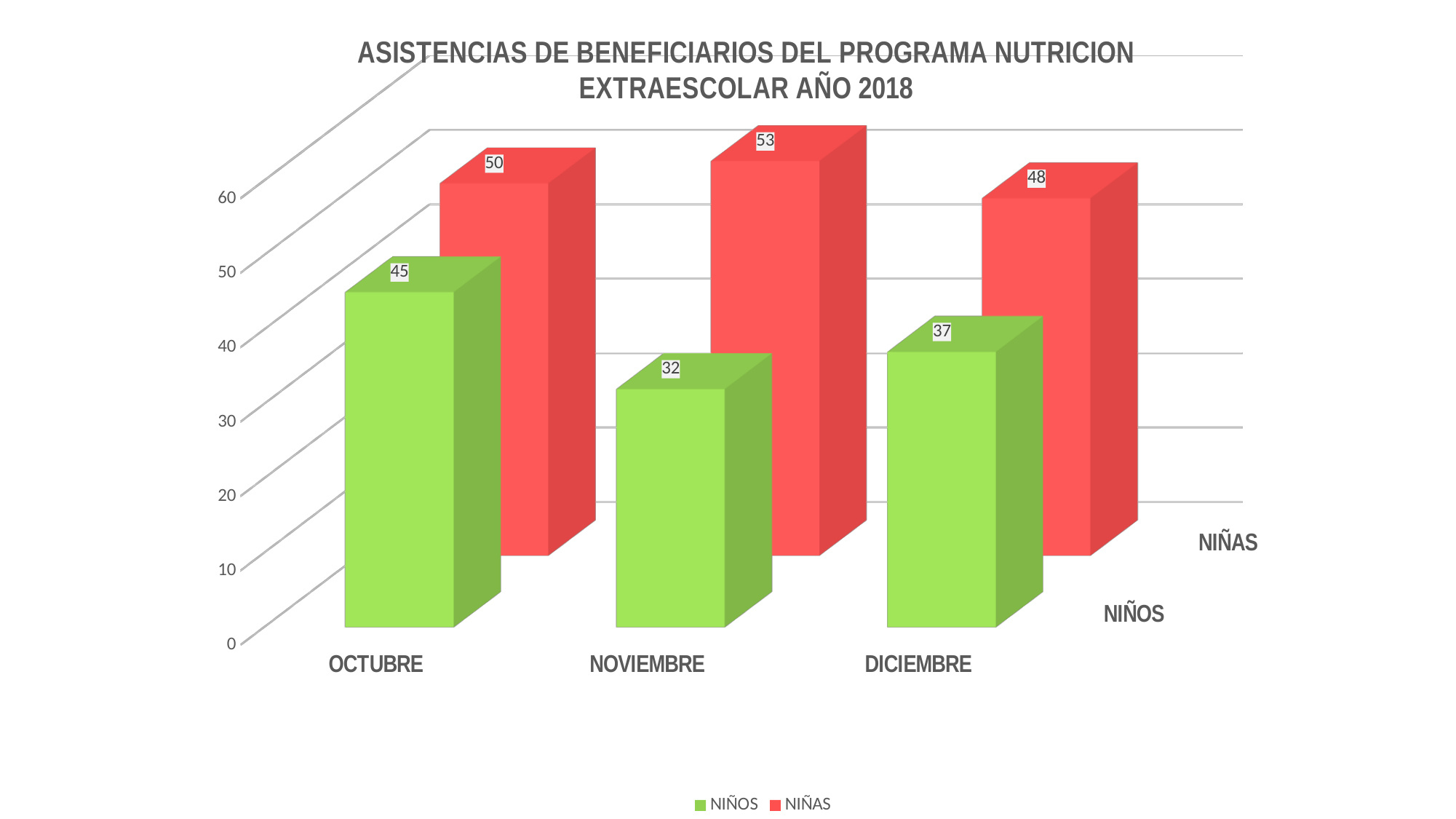
In which month is the NIÑAS value highest? NOVIEMBRE Which is larger in OCTUBRE, the NIÑOS value or the NIÑAS value? NIÑAS What is the value for NIÑOS in DICIEMBRE? 37 What kind of chart is shown on the slide? Bar chart In which month is the NIÑOS value lowest? NOVIEMBRE What is the value for NIÑOS in OCTUBRE? 45 How many series does the legend list? 2 Which colour represents the NIÑAS series? Red What is the value for NIÑAS in NOVIEMBRE? 53 What is the difference between the NIÑAS and NIÑOS values in NOVIEMBRE? 21 What is the value for NIÑAS in DICIEMBRE? 48 How many months are shown on the x axis? 3